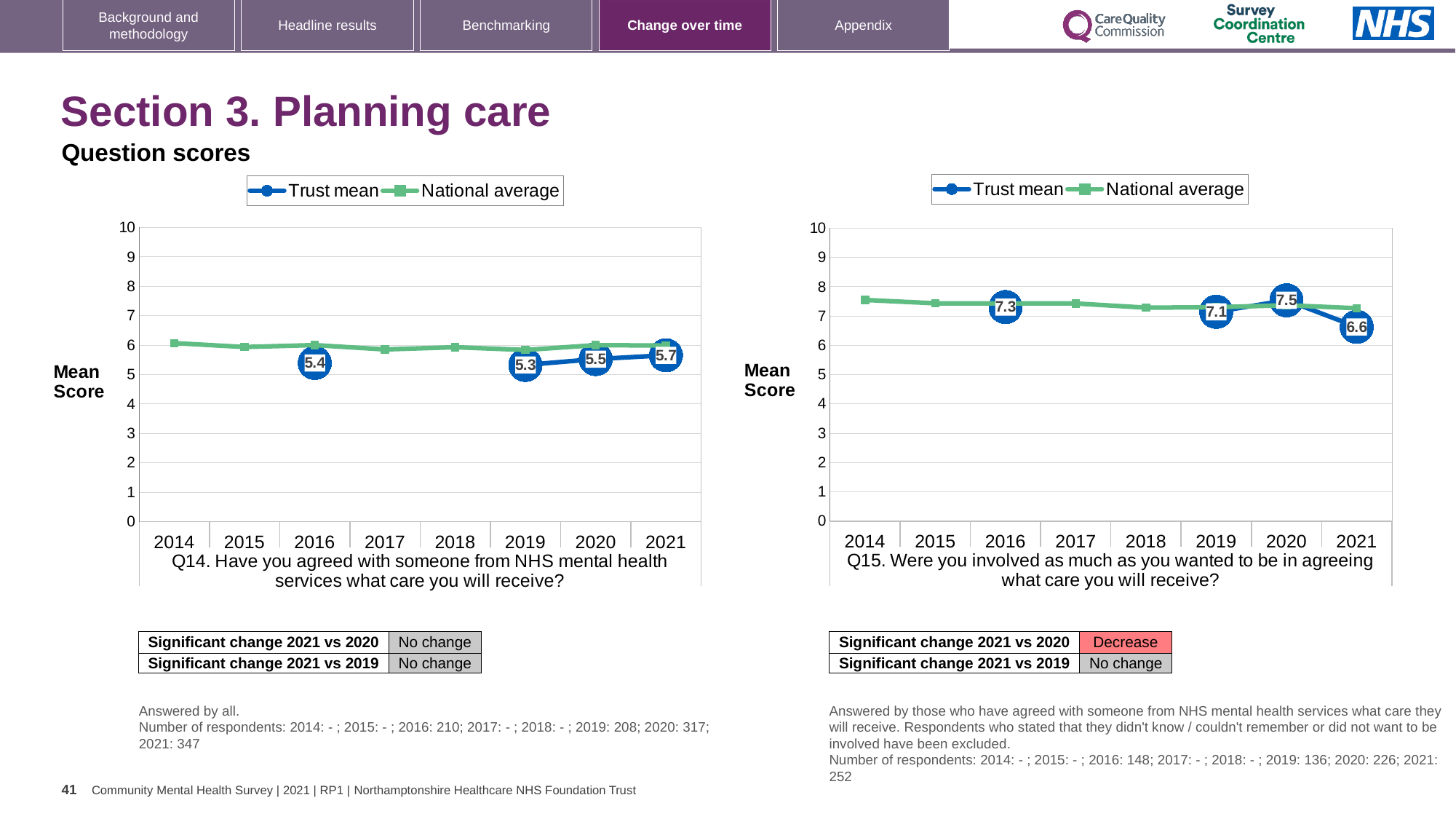
How many series does the legend of the Q15 chart list? 2 In the Q14 chart, is the Trust mean score higher in 2016 or in 2019? 2016 In the Q14 chart, which year has the highest labelled Trust mean score? 2021 What type of chart is used for Q15? Line chart In the Q14 chart, what is the Trust mean score for 2019? 5.3 In the Q15 chart, is the National average value for 2014 greater or less than 7? greater How many years are shown on the x axis of the Q14 chart? 8 In the Q15 chart, what is the difference between the Trust mean scores for 2020 and 2021? 0.9 In the Q15 chart, what is the Trust mean score for 2021? 6.6 In the Q14 chart, what is the Trust mean score for 2021? 5.7 In the Q15 chart, which year has the lowest labelled Trust mean score? 2021 In the Q15 chart, what is the Trust mean score for 2020? 7.5